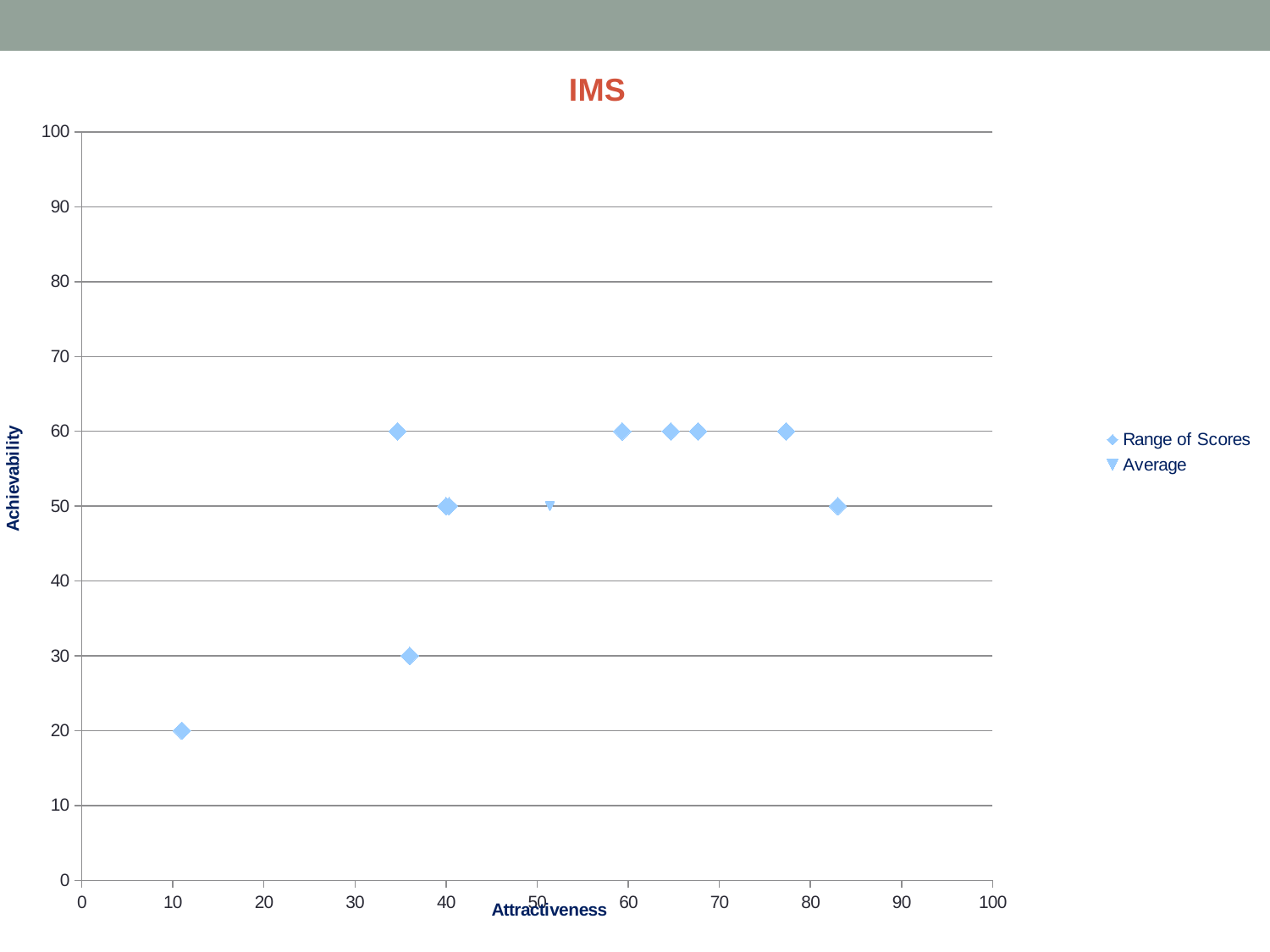
Is the Attractiveness value of the Average point greater or less than 40? greater How many series does the legend list? 2 What is the highest Achievability value reached by any plotted point? 60 What kind of chart is shown on the slide? Scatter chart What is the Achievability value of the Average point? 50 What is the lowest Achievability value reached by any plotted point? 20 What is the title of the chart? IMS What is the Achievability value of the point with the highest Attractiveness? 50 What is the Achievability value of the point with the lowest Attractiveness? 20 What are the titles of the x axis and the y axis? Attractiveness (x axis) and Achievability (y axis) How many Range of Scores points are plotted at an Achievability of 60? 5 Is the Attractiveness value of the point with Achievability 20 greater or less than 20? less